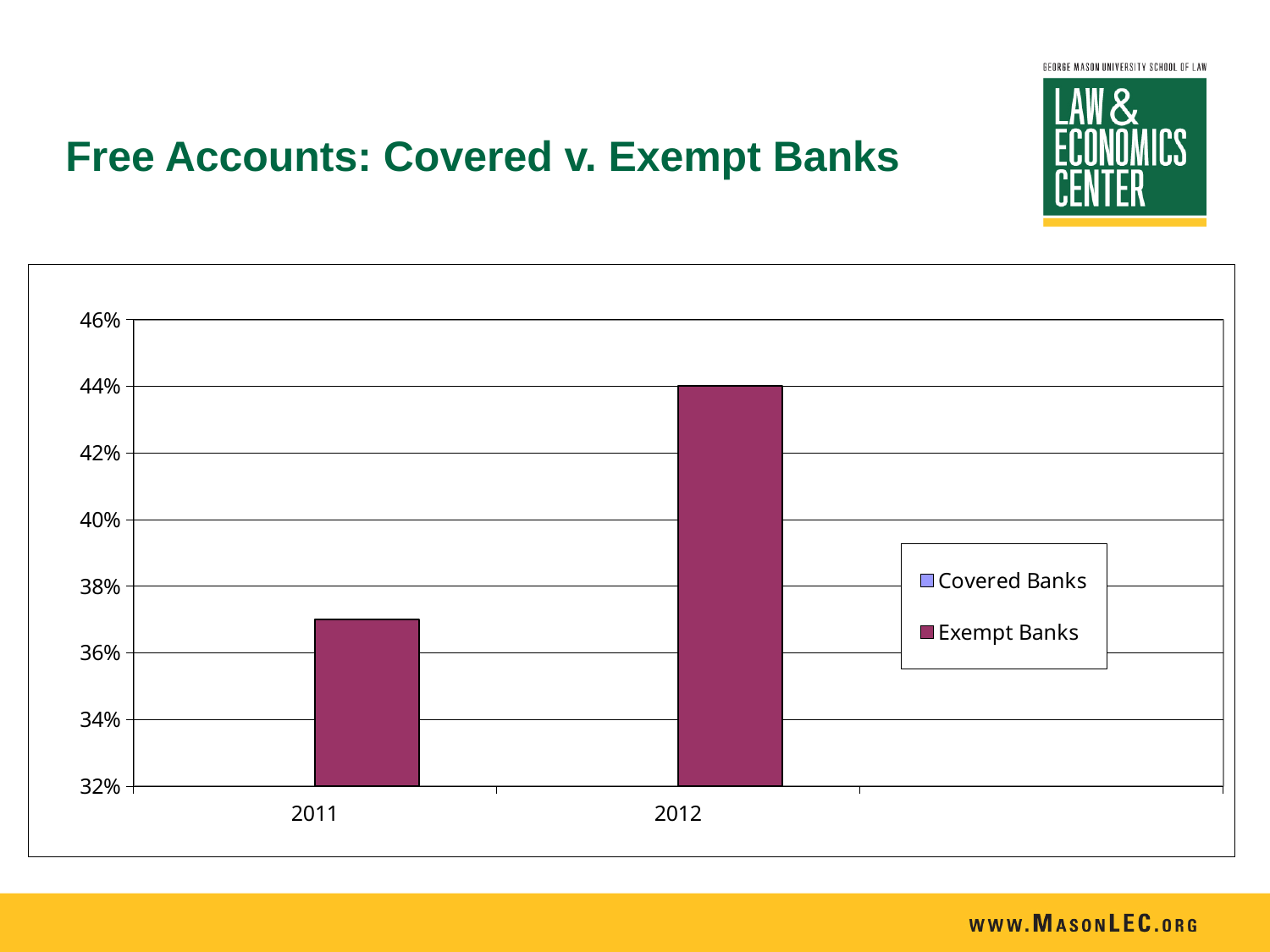
Which year has the higher Exempt Banks value, 2011 or 2012? 2012 How many years are shown on the x axis? 2 In which year is the Exempt Banks value lowest? 2011 Is the Exempt Banks value for 2011 greater or less than 36%? greater In which year is the Exempt Banks value highest? 2012 Is the Exempt Banks value for 2012 greater or less than 42%? greater What is the title of the slide containing the chart? Free Accounts: Covered v. Exempt Banks How many series does the legend list? 2 Does the Exempt Banks value rise or fall from 2011 to 2012? rise Is the Exempt Banks value for 2011 greater or less than 38%? less What kind of chart is shown on the slide? bar chart What are the two series named in the legend? Covered Banks and Exempt Banks